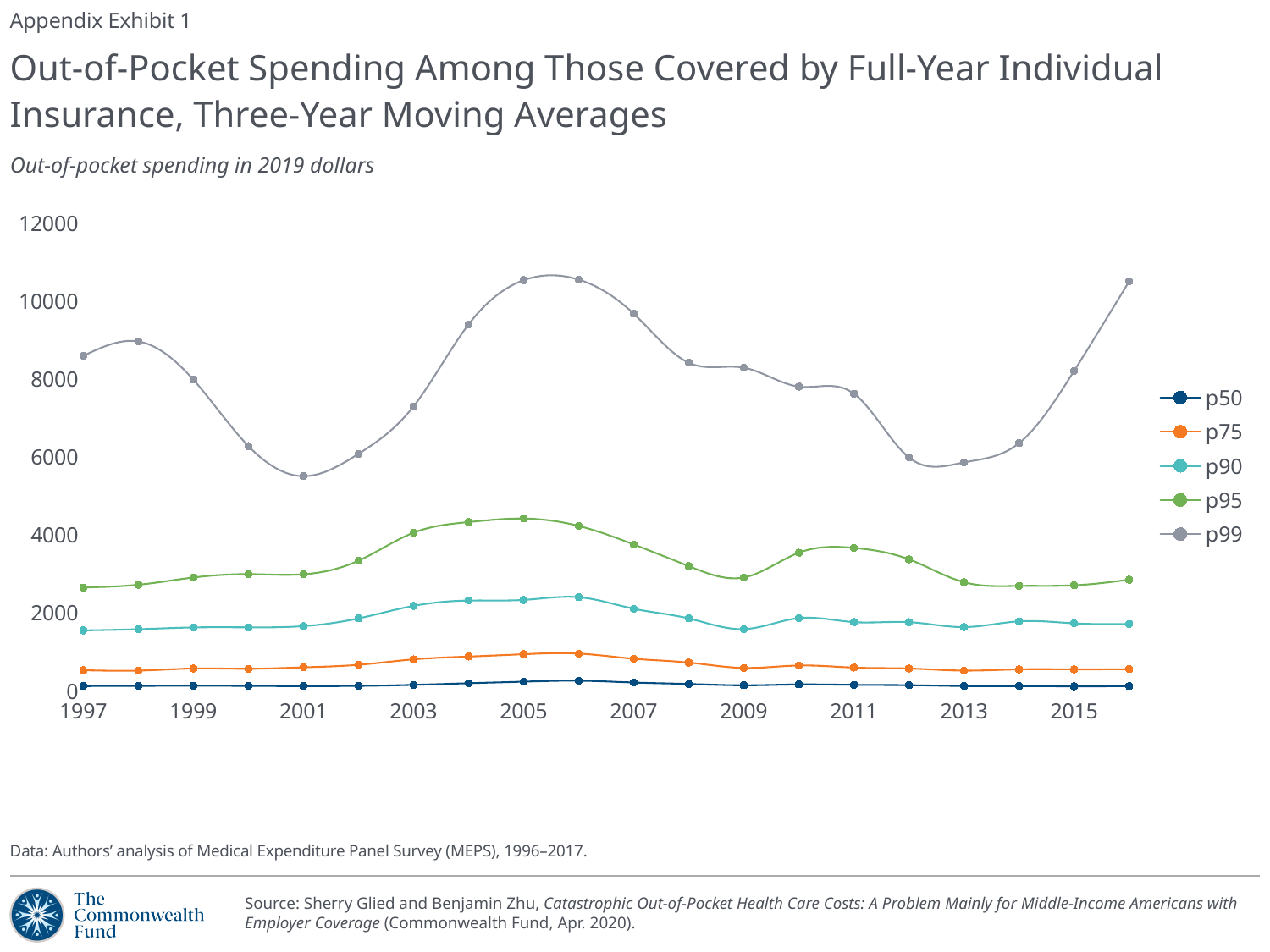
Is the value for p99 in 2001 greater or less than 6000? less Is the value for p95 in 2005 greater or less than 4000? greater Which is larger for p95: the value in 2006 or the value in 2013? 2006 Is the value for p90 in 2009 greater or less than 2000? less Which is larger for p99: the value in 2005 or the value in 2001? 2005 Does the p99 line rise or fall from 2012 to 2016? rise How many data points does each line have? 20 Which series is shown in orange in the legend? p75 How many series does the legend list? 5 What kind of chart is shown on the slide? line chart